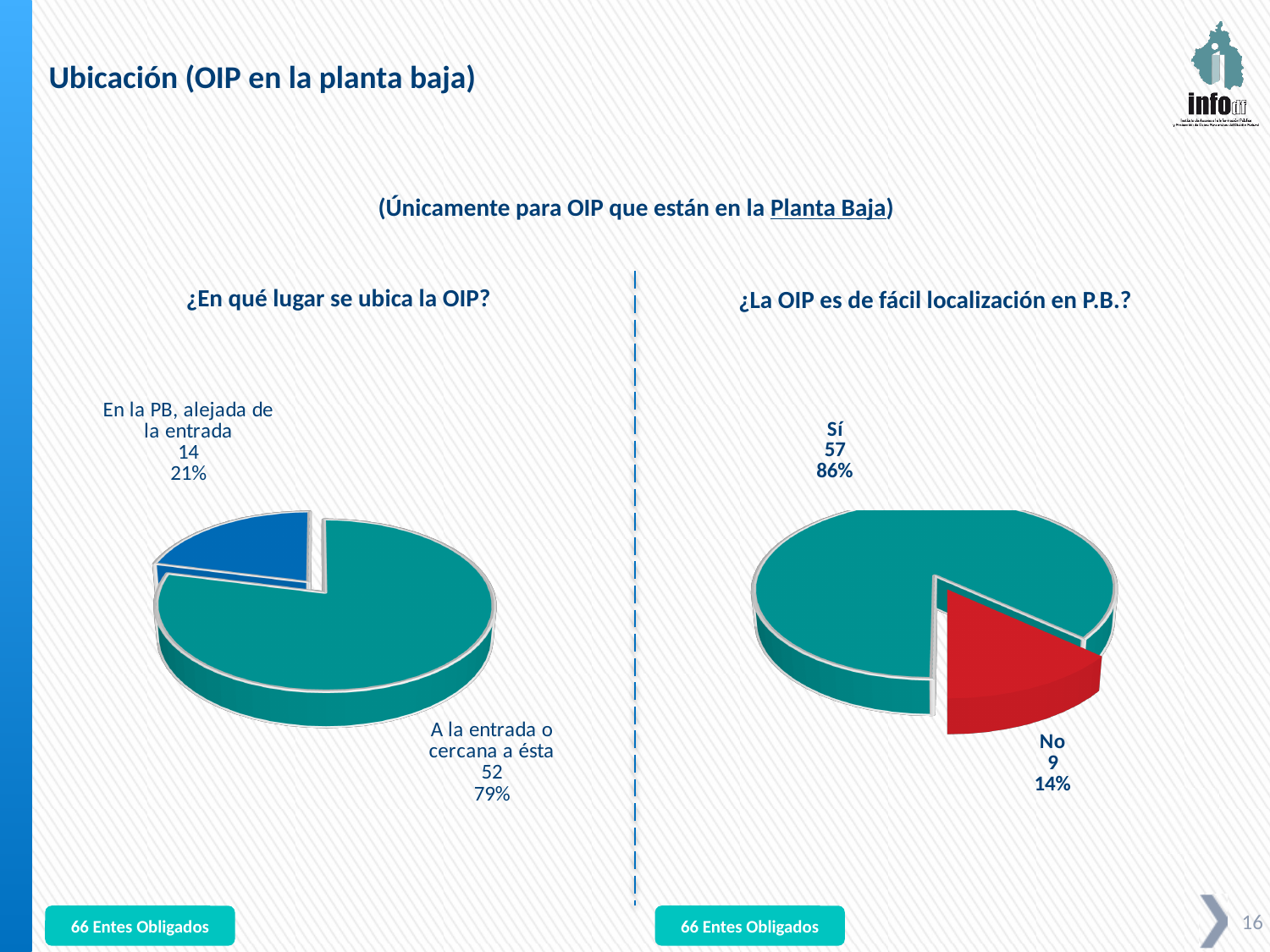
In the chart '¿La OIP es de fácil localización en P.B.?', what is the total of 'Sí' and 'No'? 66 What kind of chart is '¿La OIP es de fácil localización en P.B.?'? Pie chart In the chart '¿En qué lugar se ubica la OIP?', how many categories are shown? 2 In the chart '¿La OIP es de fácil localización en P.B.?', which category is the smallest? No In the chart '¿En qué lugar se ubica la OIP?', what is the difference between the values for 'A la entrada o cercana a ésta' and 'En la PB, alejada de la entrada'? 38 In the chart '¿En qué lugar se ubica la OIP?', what is the value for 'A la entrada o cercana a ésta'? 52 In the chart '¿La OIP es de fácil localización en P.B.?', what colour is the 'No' slice? Red In the chart '¿La OIP es de fácil localización en P.B.?', what is the value for 'Sí'? 57 In the chart '¿En qué lugar se ubica la OIP?', what percentage share does 'En la PB, alejada de la entrada' have? 21% In the chart '¿La OIP es de fácil localización en P.B.?', what percentage share does 'No' have? 14% In the chart '¿En qué lugar se ubica la OIP?', which category is the largest? A la entrada o cercana a ésta In the chart '¿La OIP es de fácil localización en P.B.?', which is larger, 'Sí' or 'No'? Sí